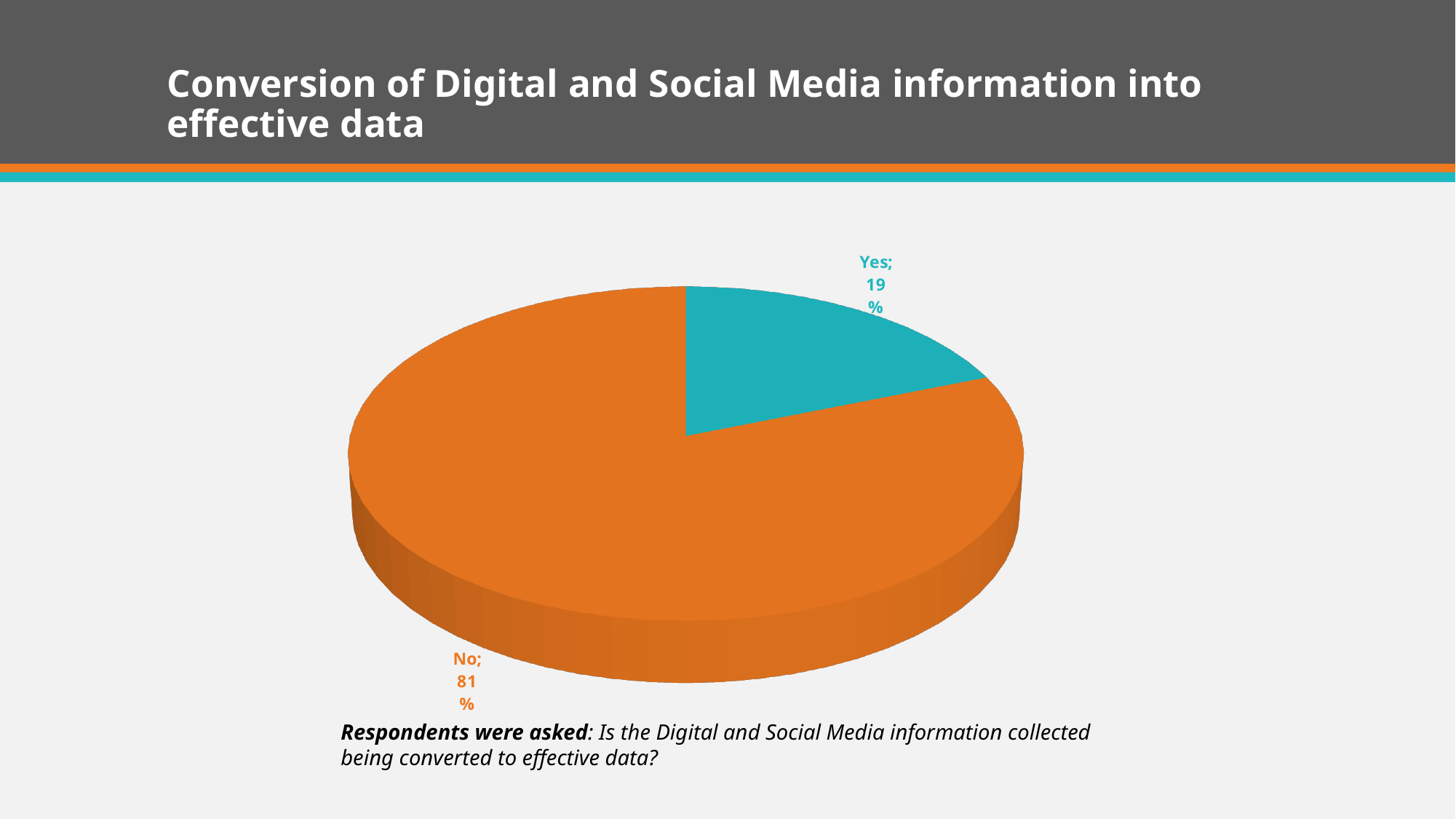
Which response has the largest share of the pie? No What kind of chart is shown on the slide? Pie chart What colour is the "Yes" slice? Teal Which response has the smallest share of the pie? Yes What percentage of respondents answered "No"? 81% What colour is the "No" slice? Orange How many slices does the pie chart have? 2 What percentage of respondents answered "Yes"? 19% Which slice is larger, "Yes" or "No"? No What share of the pie does the "No" slice represent? 81% What is the difference in percentage points between the "No" and "Yes" slices? 62